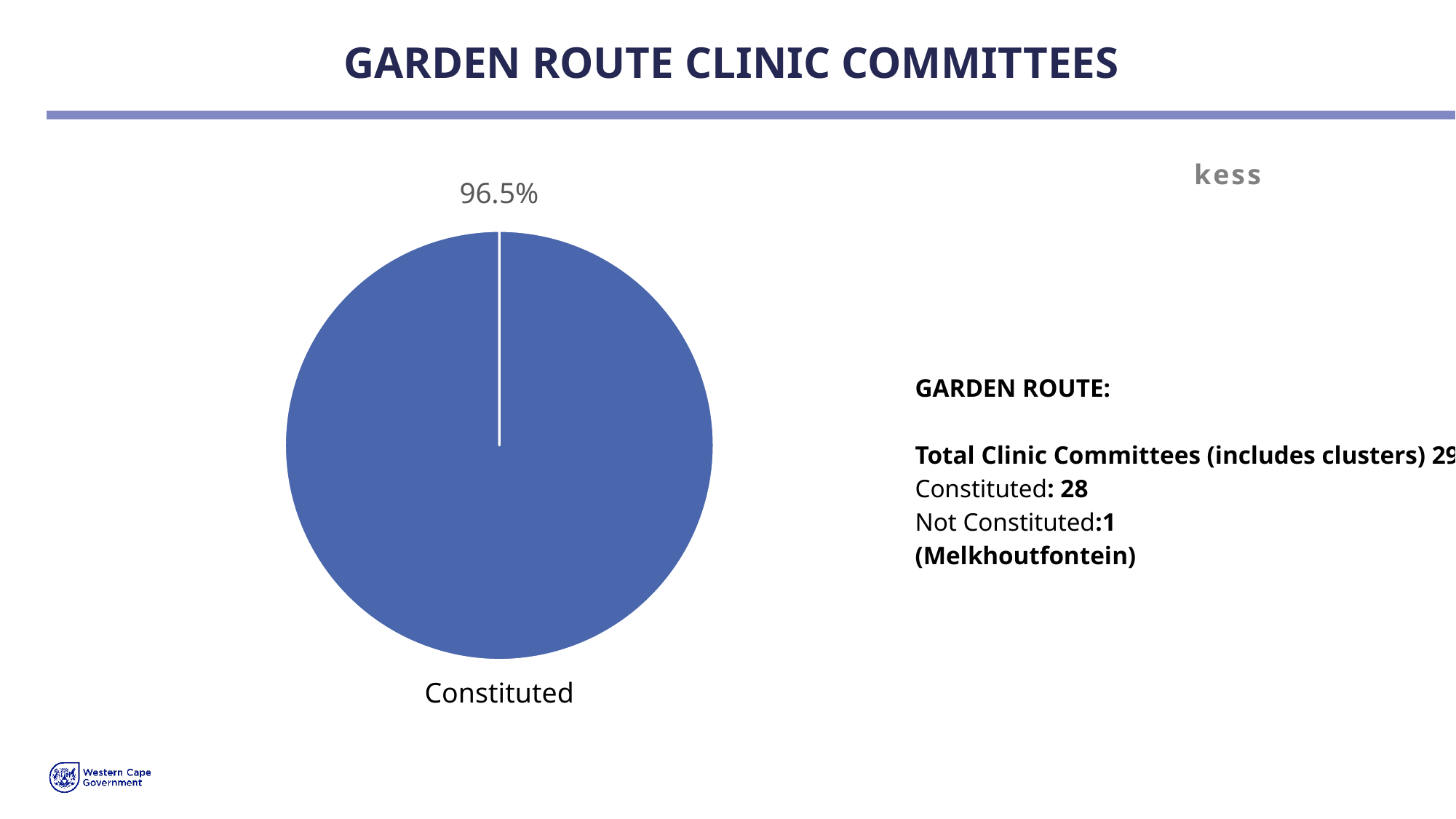
Is the share for Constituted greater or less than 90%? greater What kind of chart is shown on the slide? pie chart Which category is labelled below the pie chart? Constituted What colour is the Constituted slice of the pie chart? blue What is the title of the slide containing the pie chart? GARDEN ROUTE CLINIC COMMITTEES What percentage is shown for the Constituted slice of the pie chart? 96.5% Which category takes up the largest share of the pie chart? Constituted How many category labels are printed for the pie chart? 1